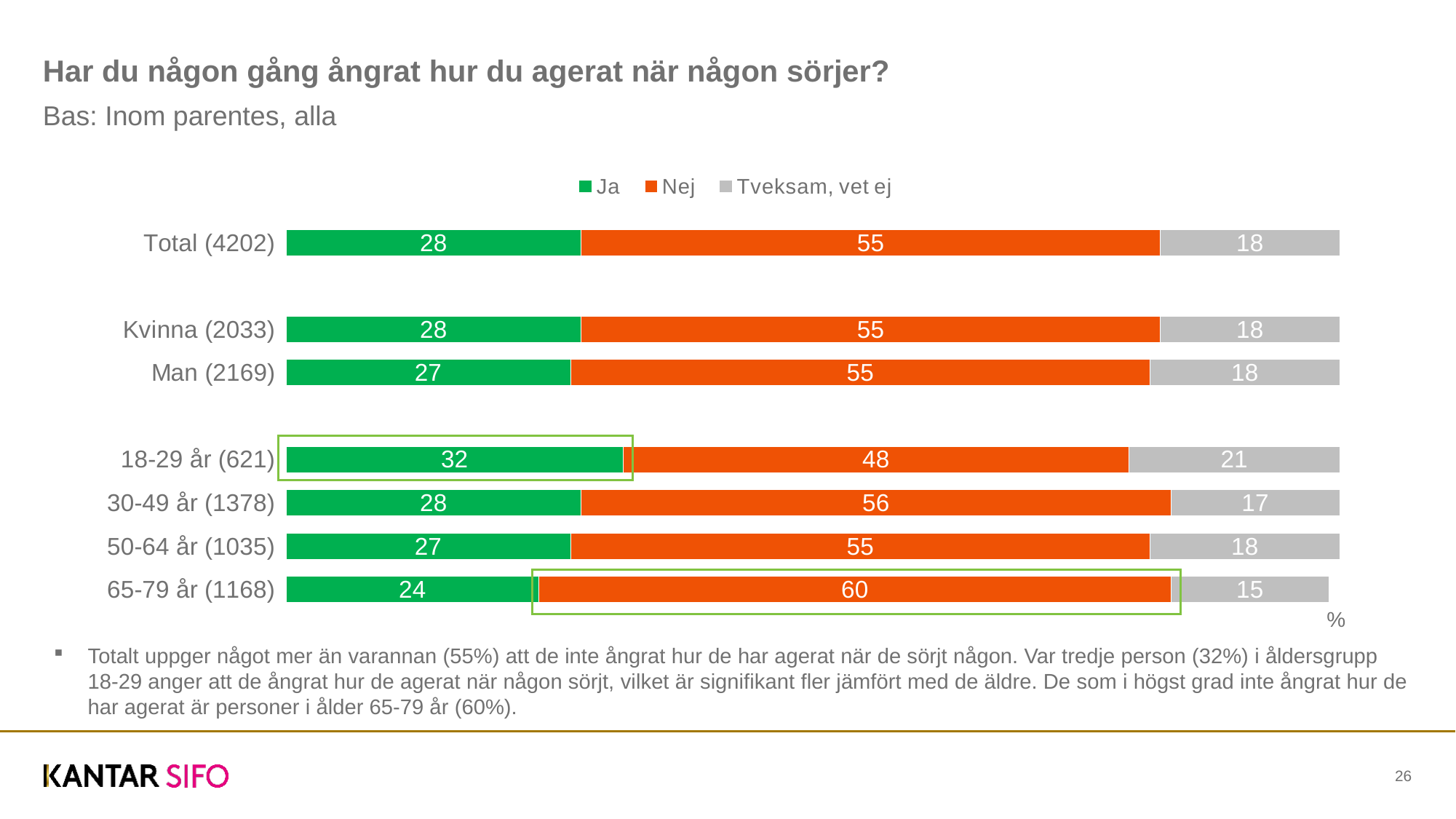
What is the "Nej" value for 65-79 år (1168)? 60 What is the difference between the "Nej" values for 65-79 år (1168) and 18-29 år (621)? 12 Which colour represents the "Nej" series in the chart? Orange How many series does the legend list? 3 What is the "Tveksam, vet ej" value for 30-49 år (1378)? 17 Which category has the highest "Ja" value? 18-29 år (621) What kind of chart is shown on the slide? Stacked bar chart What is the total of the stacked bar for 18-29 år (621)? 101 Which is larger: the "Ja" value for Kvinna (2033) or for Man (2169)? Kvinna (2033) How many categories are shown in the chart? 7 Which category has the lowest "Nej" value? 18-29 år (621) What is the "Ja" value for 18-29 år (621)? 32